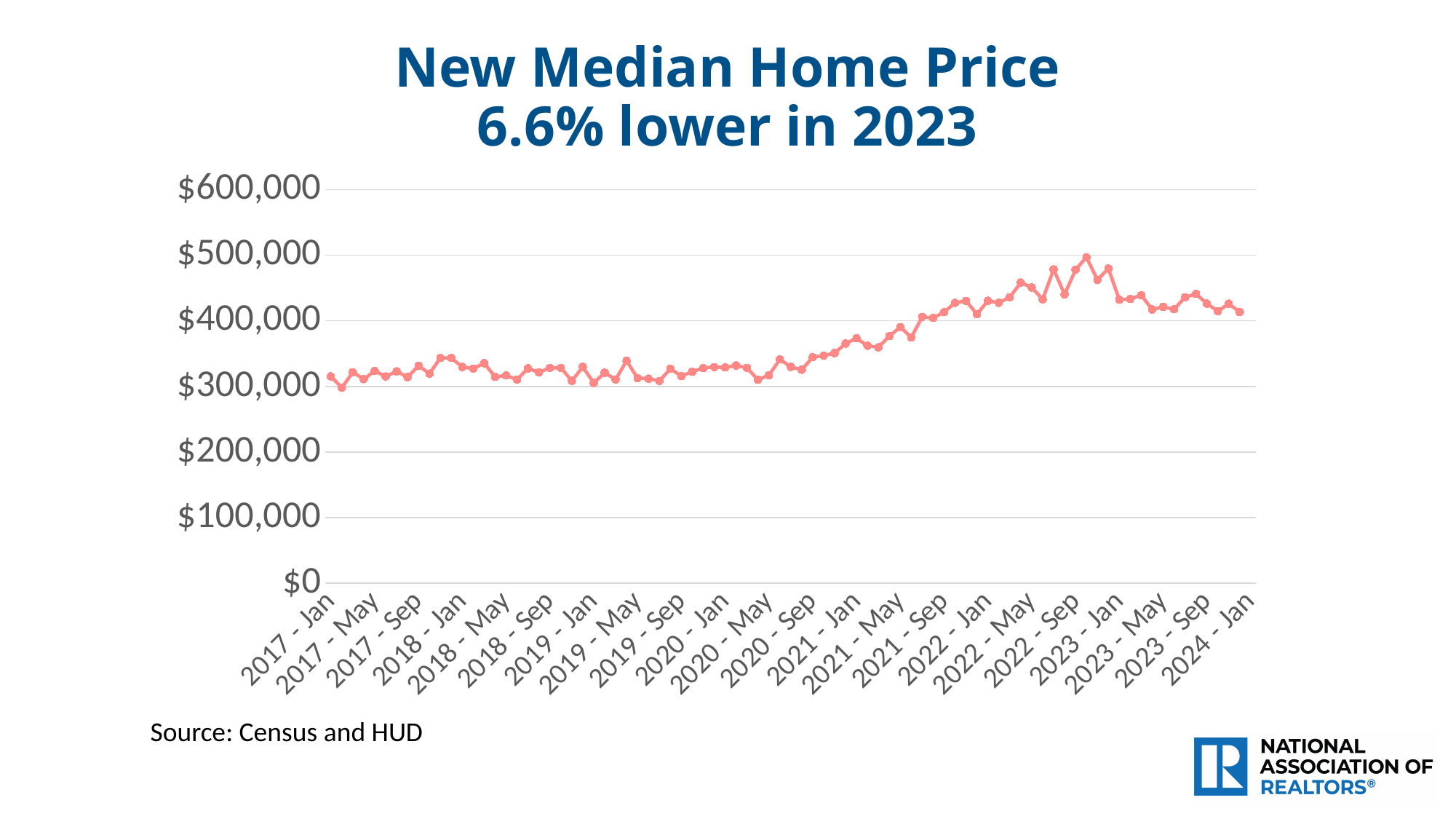
What is the title of the chart? New Median Home Price 6.6% lower in 2023 What kind of chart is shown on the slide? Line chart Is the value for 2023 - Jan greater or less than $400,000? greater Which is larger, the value for 2022 - Sep or the value for 2017 - Sep? 2022 - Sep What source is cited for the chart data? Census and HUD Is the value for 2018 - Jan greater or less than $400,000? less Is the value for 2017 - May greater or less than $500,000? less Overall, do the values rise or fall from 2017 - Jan to 2024 - Jan? Rise